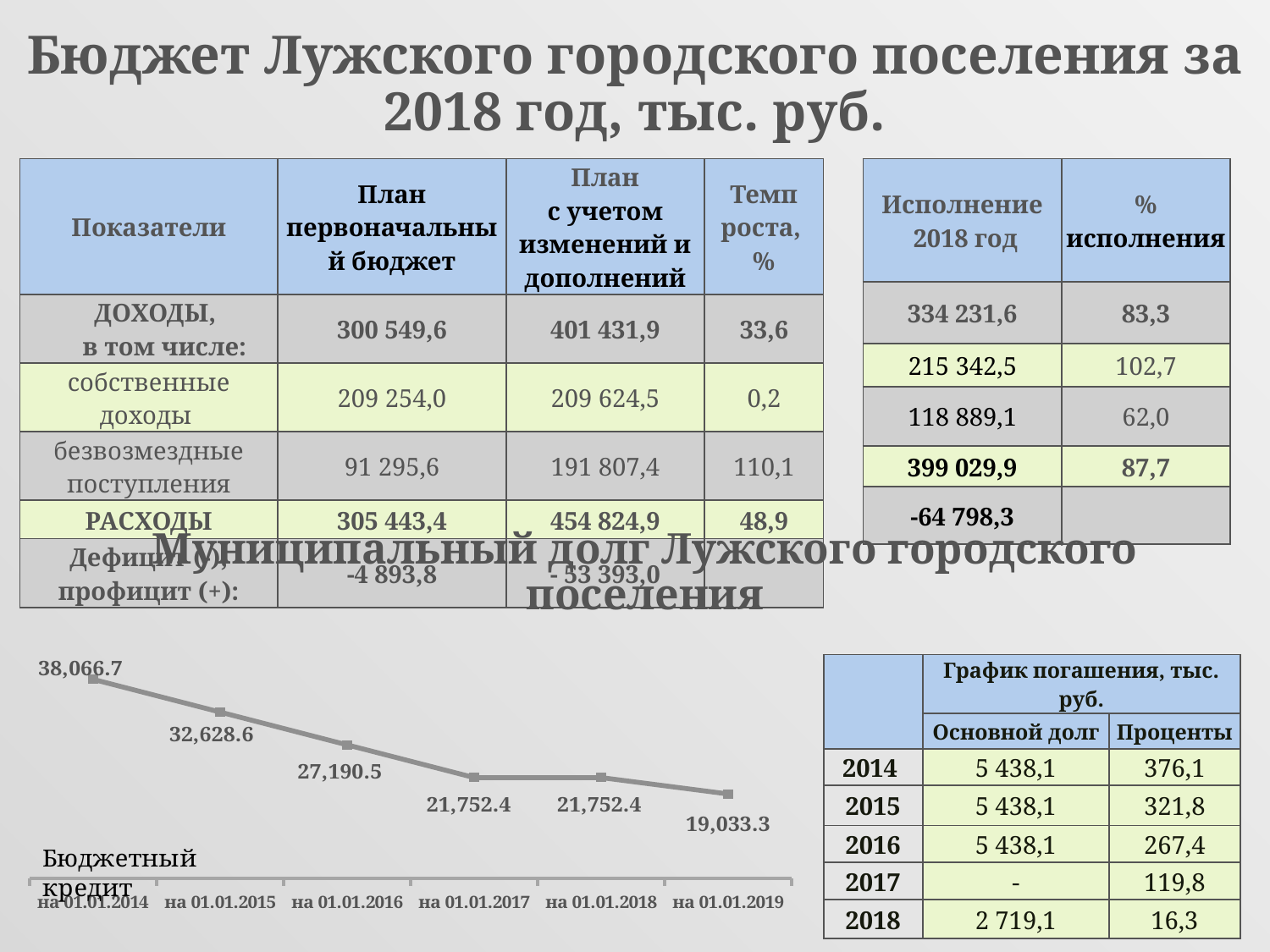
How many data points are plotted in the line chart? 6 In the line chart, what is the difference between the values on 01.01.2015 and 01.01.2016? 5,438.1 In the line chart, what is the value on 01.01.2014? 38,066.7 In the line chart, which is larger: the value on 01.01.2016 or on 01.01.2018? на 01.01.2016 In the line chart, what is the value on 01.01.2019? 19,033.3 In the line chart, what is the value on 01.01.2018? 21,752.4 In the line chart, do the values rise or fall from 01.01.2014 to 01.01.2019? fall In the line chart, which date has the lowest value? на 01.01.2019 What type of chart is shown at the bottom left of the slide? line chart In the line chart, what is the difference between the values on 01.01.2014 and 01.01.2019? 19,033.4 In the line chart, what is the value on 01.01.2016? 27,190.5 In the line chart, which date has the highest value? на 01.01.2014